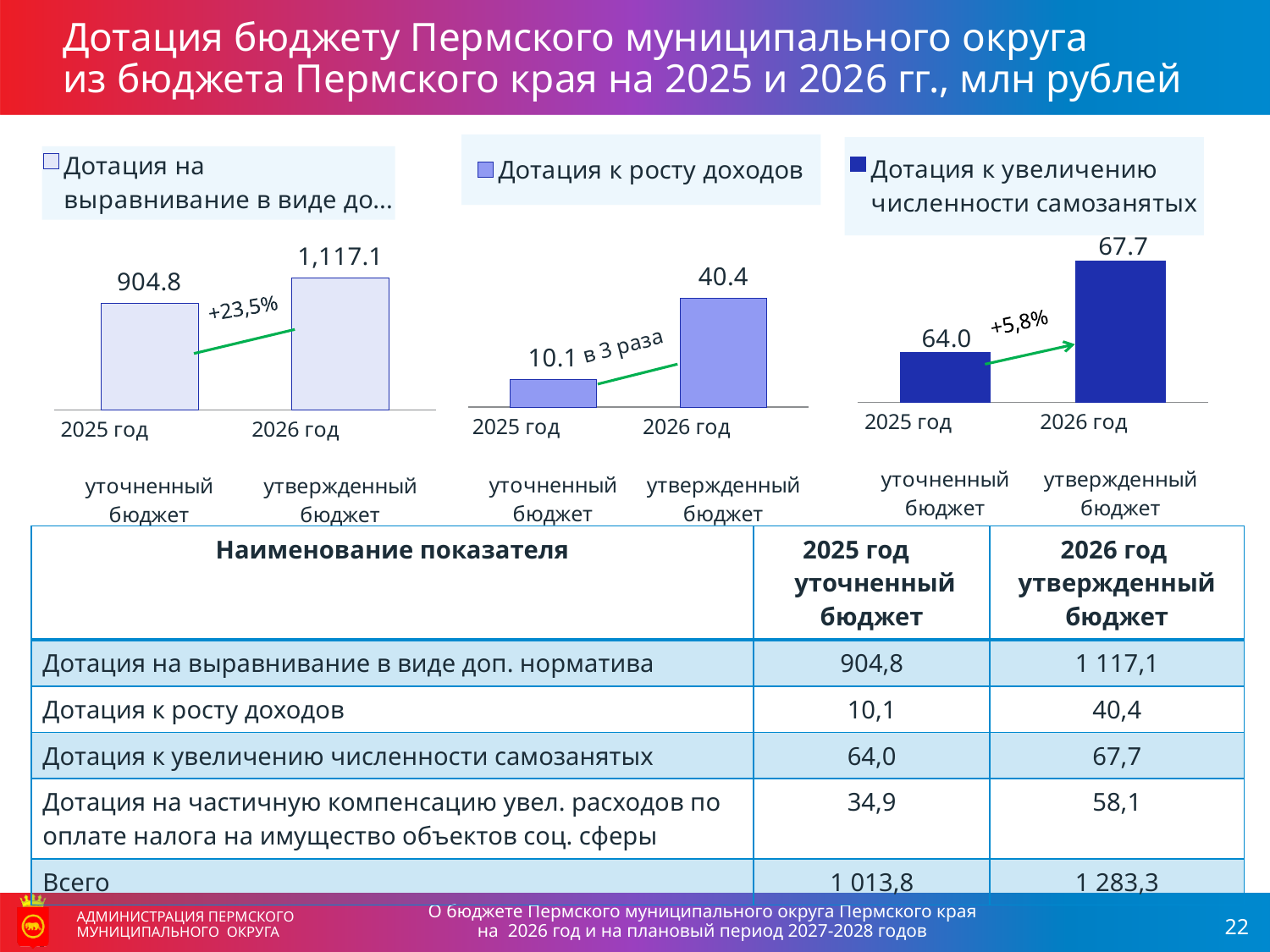
In the left chart (Дотация на выравнивание), what is the value for 2026 год? 1,117.1 In the right chart (Дотация к увеличению численности самозанятых), is the value for 2025 год larger or smaller than the value for 2026 год? smaller What percentage change is annotated on the left chart (Дотация на выравнивание) between 2025 and 2026? +23,5% In the right chart (Дотация к увеличению численности самозанятых), what is the value for 2025 год? 64.0 How many bars are shown in the left chart (Дотация на выравнивание)? 2 What type of chart is the middle chart (Дотация к росту доходов)? bar chart In the middle chart (Дотация к росту доходов), what is the value for 2026 год? 40.4 In the middle chart (Дотация к росту доходов), what is the value for 2025 год? 10.1 In the right chart (Дотация к увеличению численности самозанятых), what is the value for 2026 год? 67.7 In the left chart (Дотация на выравнивание), which year has the higher value? 2026 год In the middle chart (Дотация к росту доходов), what is the difference between the 2026 год and 2025 год values? 30.3 In the left chart (Дотация на выравнивание), what is the value for 2025 год? 904.8